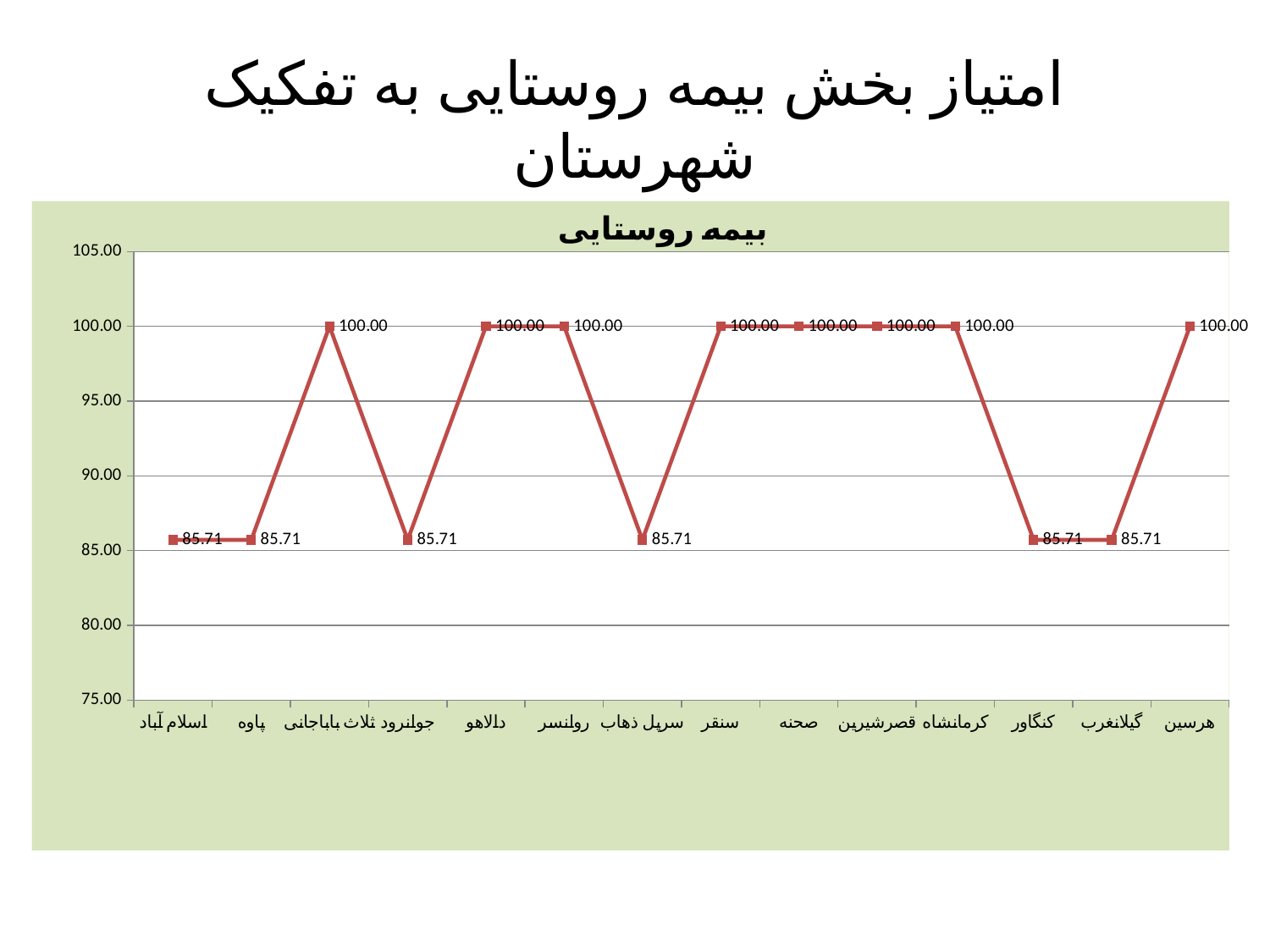
What is the value for پاوه? 85.71 How many categories have a value of 100.00? 8 What is the value for کرمانشاه? 100.00 Is the value for اسلام آباد greater or less than 90.00? less What is the title of the chart? بیمه روستایی What is the difference between the value for دالاهو and the value for کنگاور? 14.29 How many categories are plotted on the x axis? 14 Which is larger, the value for صحنه or the value for گیلانغرب? صحنه What is the value for هرسین? 100.00 What is the value for جوانرود? 85.71 What type of chart is shown on the slide? line chart What is the value for سرپل ذهاب? 85.71